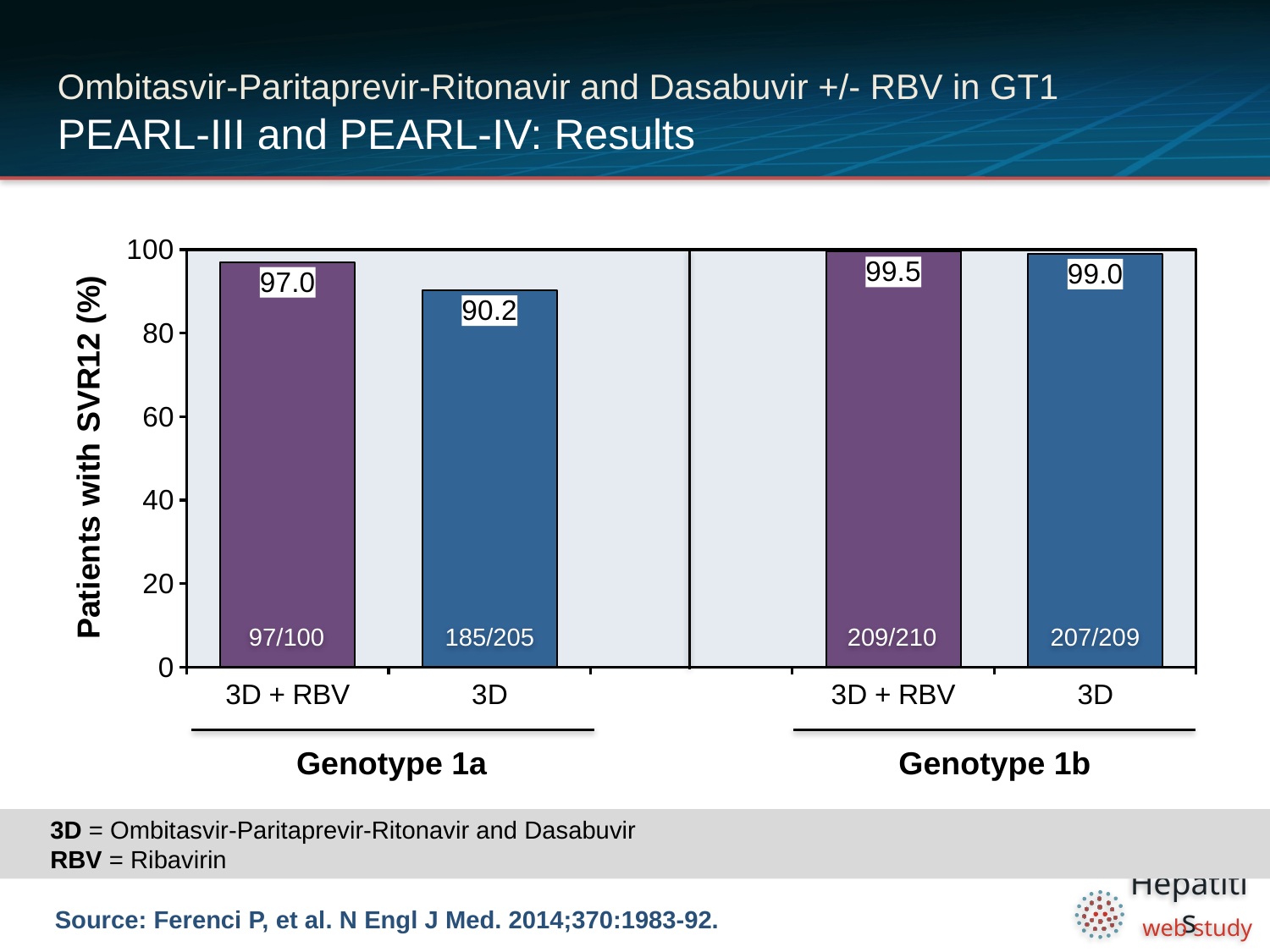
Which has a higher SVR12 rate: 3D in Genotype 1a or 3D in Genotype 1b? 3D in Genotype 1b What fraction of patients achieved SVR12 with 3D + RBV in Genotype 1b? 209/210 What is the difference in SVR12 rate between 3D + RBV and 3D in Genotype 1b? 0.5 How many bars are plotted on the chart? 4 What is the difference in SVR12 rate between 3D + RBV and 3D in Genotype 1a? 6.8 What fraction of patients achieved SVR12 with 3D alone in Genotype 1a? 185/205 Which bar shows the highest SVR12 rate? 3D + RBV, Genotype 1b Which bar shows the lowest SVR12 rate? 3D, Genotype 1a What kind of chart is shown on the slide? Bar chart What is the label of the y axis? Patients with SVR12 (%) What is the SVR12 rate for 3D + RBV in Genotype 1a? 97.0 What is the SVR12 rate for 3D alone in Genotype 1b? 99.0